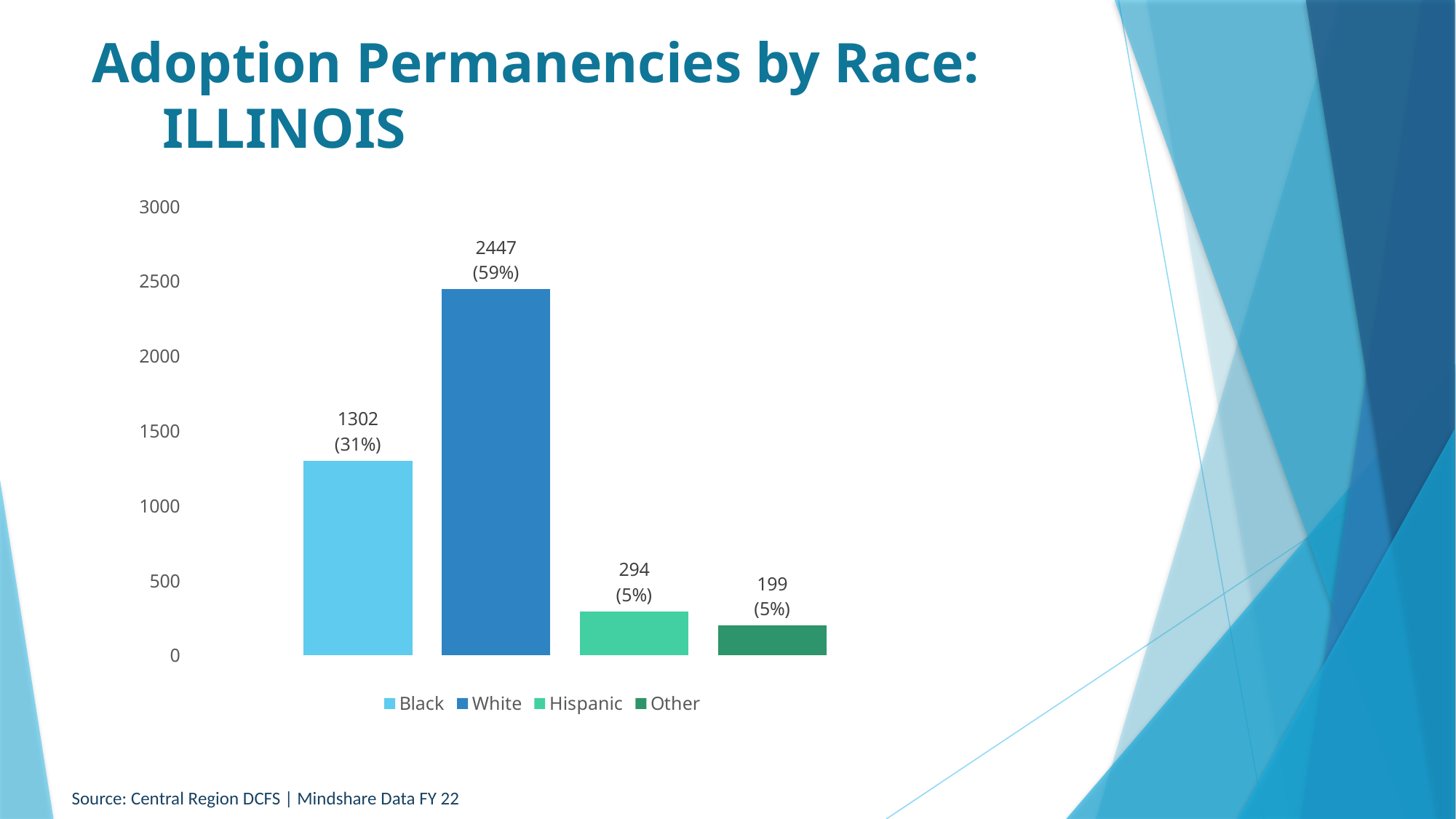
How many categories are shown in the chart? 4 What is the value for Other? 199 (5%) Which category has the highest value? White What is the title of the slide? Adoption Permanencies by Race: ILLINOIS What is the value for Hispanic? 294 (5%) What is the value for Black? 1302 (31%) What is the difference between the values for White and Black? 1145 What kind of chart is shown on the slide? Bar chart Which is larger, the value for Hispanic or the value for Other? Hispanic What is the value for White? 2447 (59%) Which category has the lowest value? Other Is the value for Black greater or less than 1000? greater